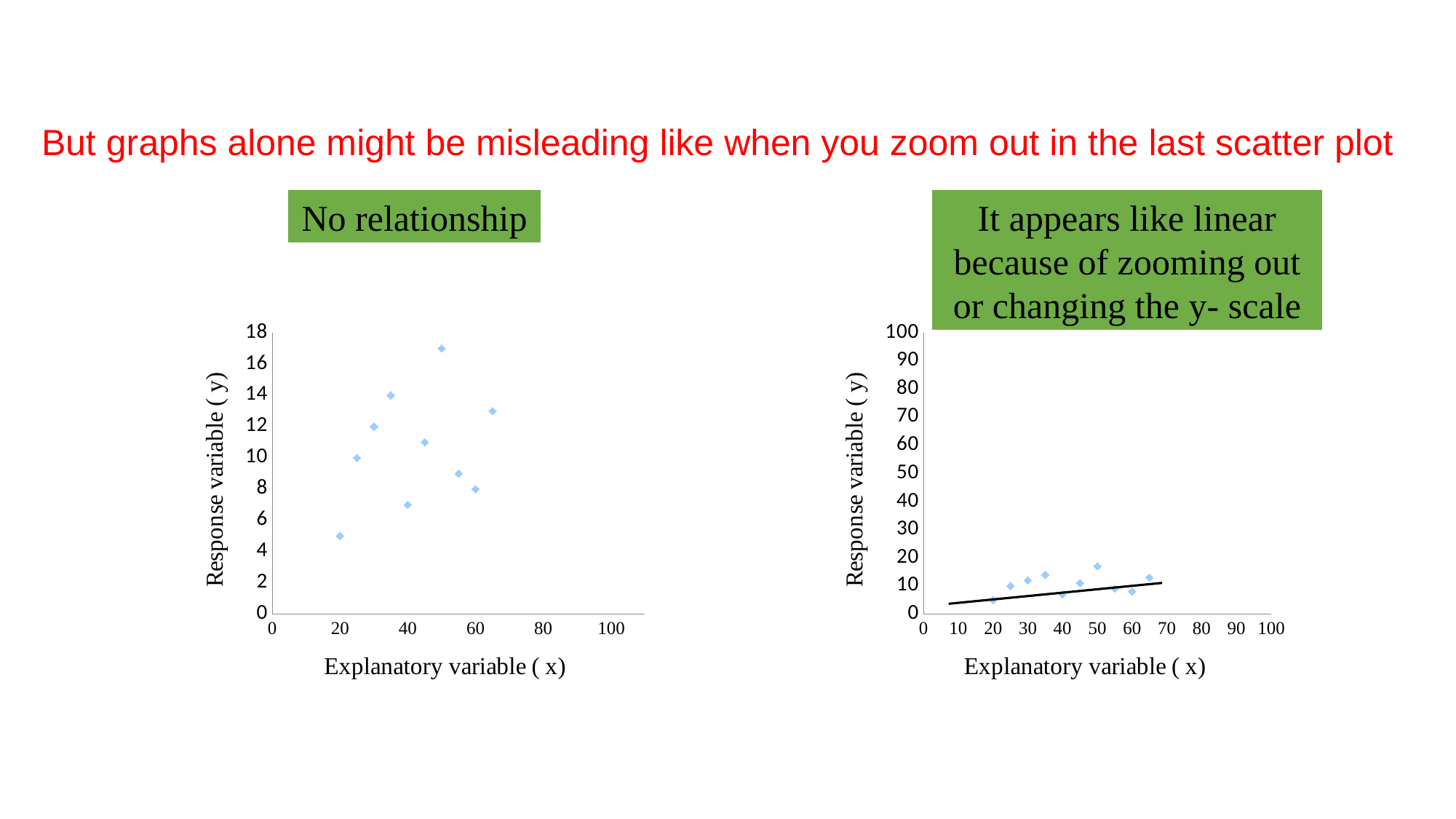
On the left chart titled 'No relationship', at which x value is the response variable highest? 50 On the right chart, is the response variable at x = 50 greater or less than 10? greater What kind of chart is the left chart titled 'No relationship'? scatter plot How many data points are plotted on the right chart? 10 On the left chart titled 'No relationship', is the response variable at x = 20 greater or less than 6? less On the left chart titled 'No relationship', which has the larger response variable: the point at x = 35 or the point at x = 40? x = 35 What is the label of the x axis on the left chart titled 'No relationship'? Explanatory variable ( x) How many data points are plotted on the left chart titled 'No relationship'? 10 What is the highest value shown on the y axis of the right chart? 100 On the left chart titled 'No relationship', is the response variable at x = 50 greater or less than 14? greater On the left chart titled 'No relationship', at which x value is the response variable lowest? 20